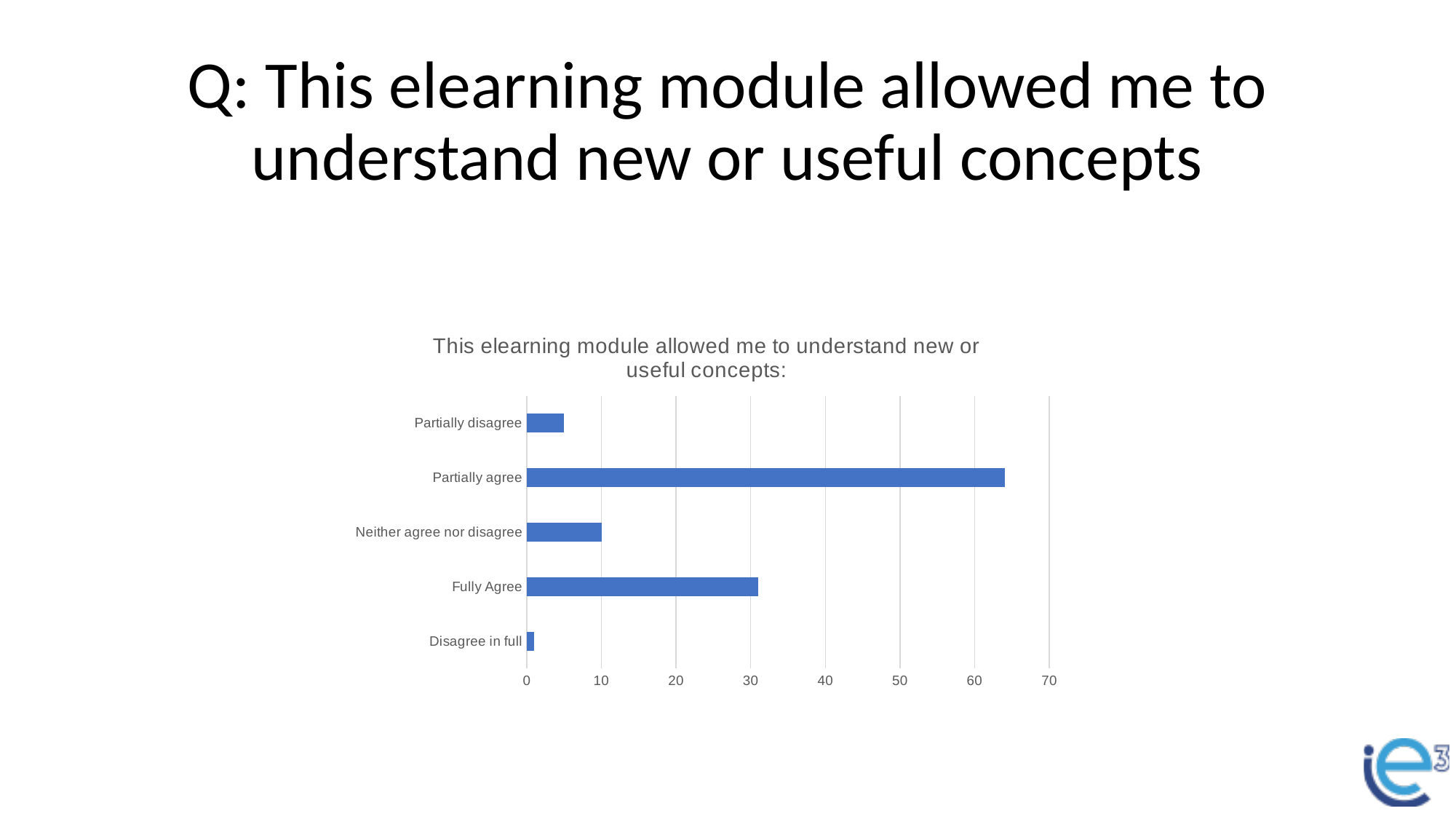
What is the title of the chart? This elearning module allowed me to understand new or useful concepts: Is the value for Partially agree greater or less than 60? greater Is the value for Disagree in full greater or less than 10? less Which is larger, the value for Partially disagree or the value for Neither agree nor disagree? Neither agree nor disagree What is the highest value shown on the horizontal axis of the chart? 70 How many categories are shown on the chart? 5 Which category has the highest value? Partially agree Which category has the lowest value? Disagree in full Which is larger, the value for Fully Agree or the value for Partially agree? Partially agree Is the value for Partially disagree greater or less than 10? less What kind of chart is shown on the slide? bar chart